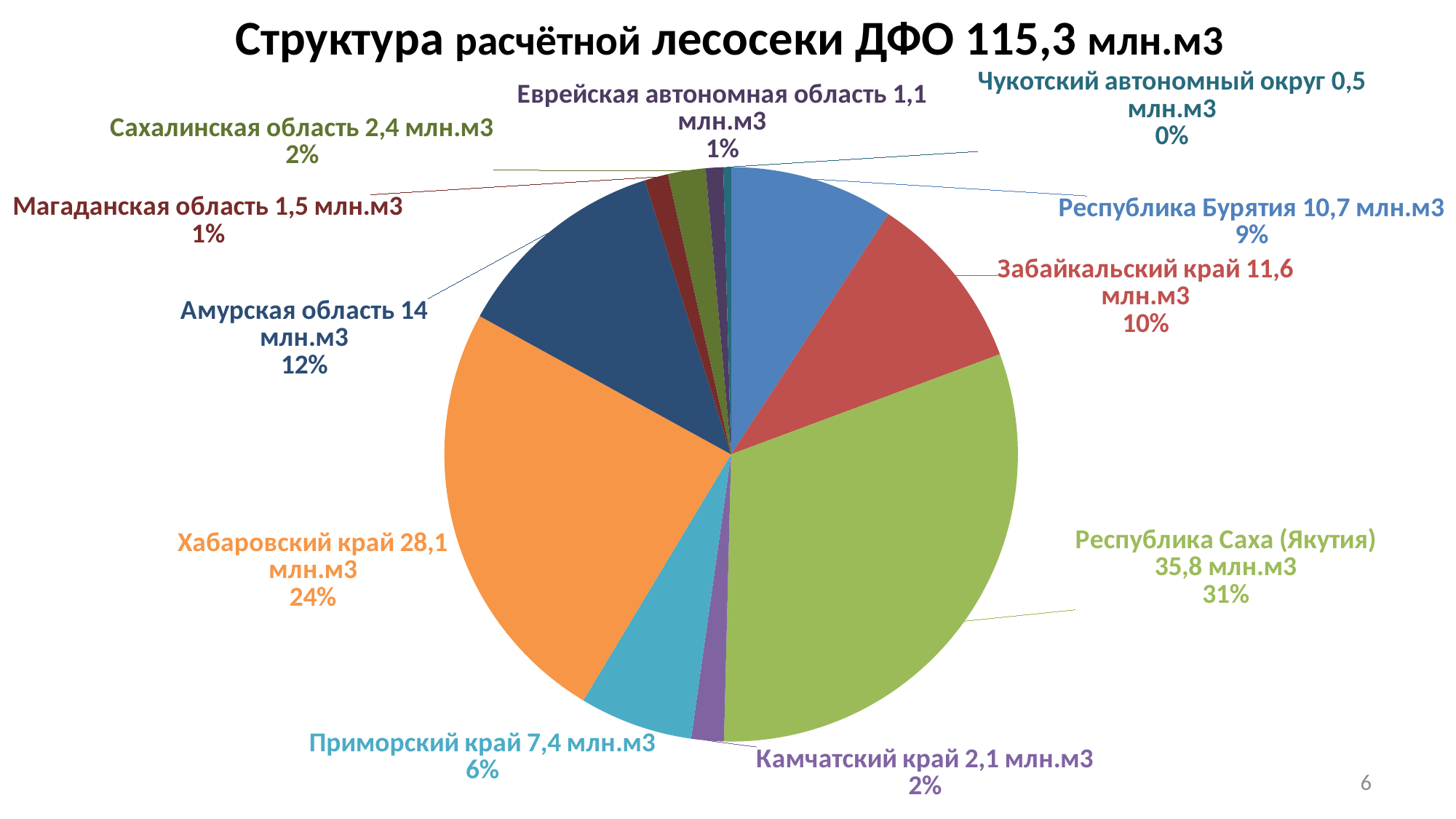
What total value is stated in the chart title? 115,3 млн.м3 What share of the pie does Приморский край account for? 6% What is the difference between the values for Забайкальский край and Республика Бурятия? 0,9 млн.м3 What share of the pie does Хабаровский край account for? 24% How many regions (slices) are shown in the pie chart? 11 What is the value for Амурская область? 14 млн.м3 Which is larger, the value for Приморский край or the value for Камчатский край? Приморский край What is the value for Сахалинская область? 2,4 млн.м3 What type of chart is shown on the slide? pie chart Which region has the largest slice of the pie? Республика Саха (Якутия) Which region has the smallest slice of the pie? Чукотский автономный округ What is the value for Республика Саха (Якутия)? 35,8 млн.м3